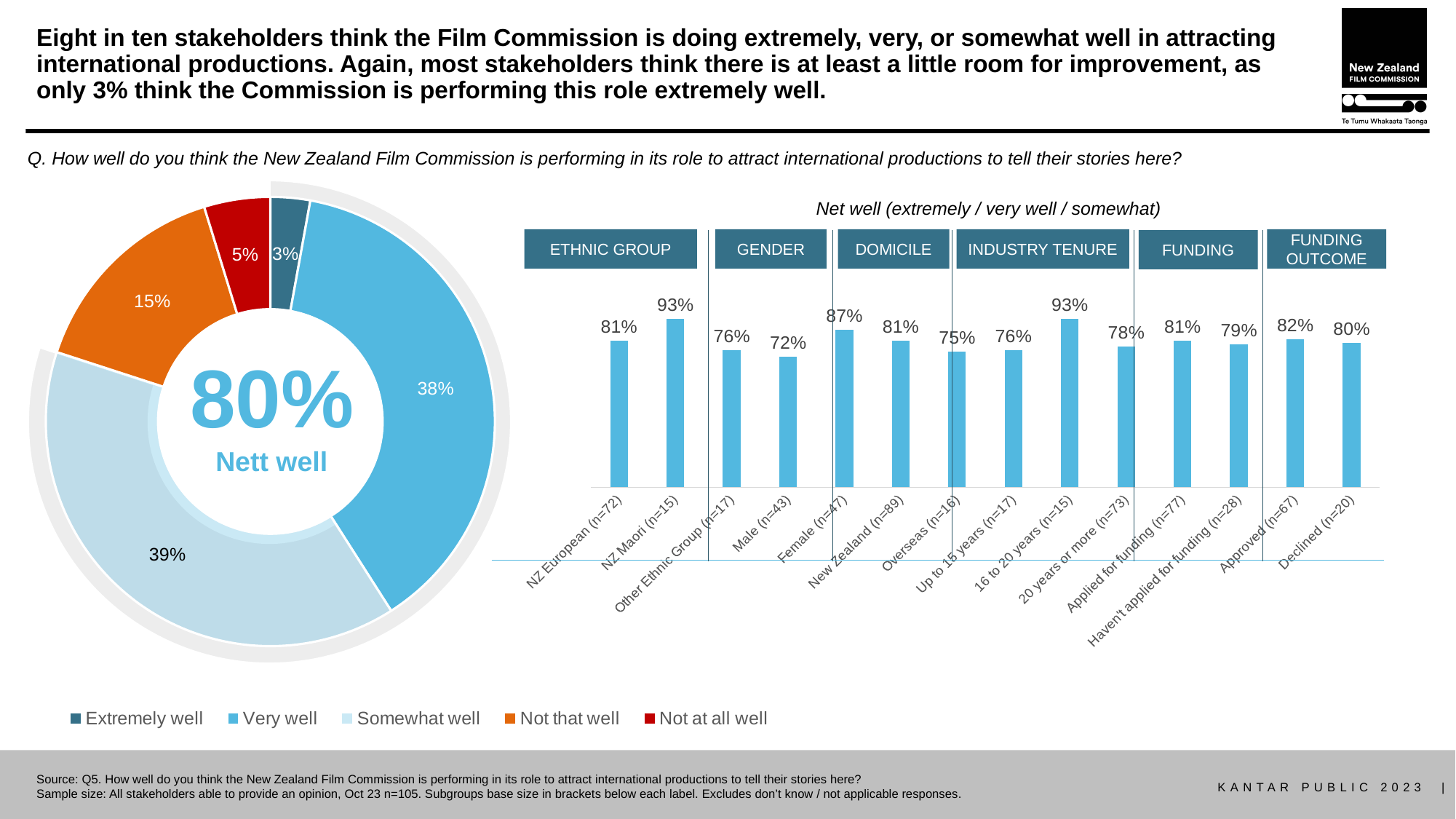
In the 'Net well' bar chart on the right, what is the value for Female (n=47)? 87% How many bars are plotted in the 'Net well' bar chart on the right? 14 How many entries does the legend of the donut chart list? 5 In the donut chart on the left, what is the difference between the 'Somewhat well' and 'Not at all well' shares? 34% In the donut chart on the left, which response category has the smallest share? Extremely well In the donut chart on the left, which response category has the largest share? Somewhat well What is the 'Nett well' figure shown in the centre of the donut chart? 80% In the 'Net well' bar chart on the right, what is the value for Declined (n=20)? 80% In the donut chart on the left, what percentage of stakeholders said 'Very well'? 38% In the 'Net well' bar chart on the right, which is larger: the value for New Zealand (n=89) or Overseas (n=16)? New Zealand (n=89) In the 'Net well' bar chart on the right, which subgroup has the lowest value? Male (n=43) In the donut chart on the left, what percentage of stakeholders said 'Not that well'? 15%